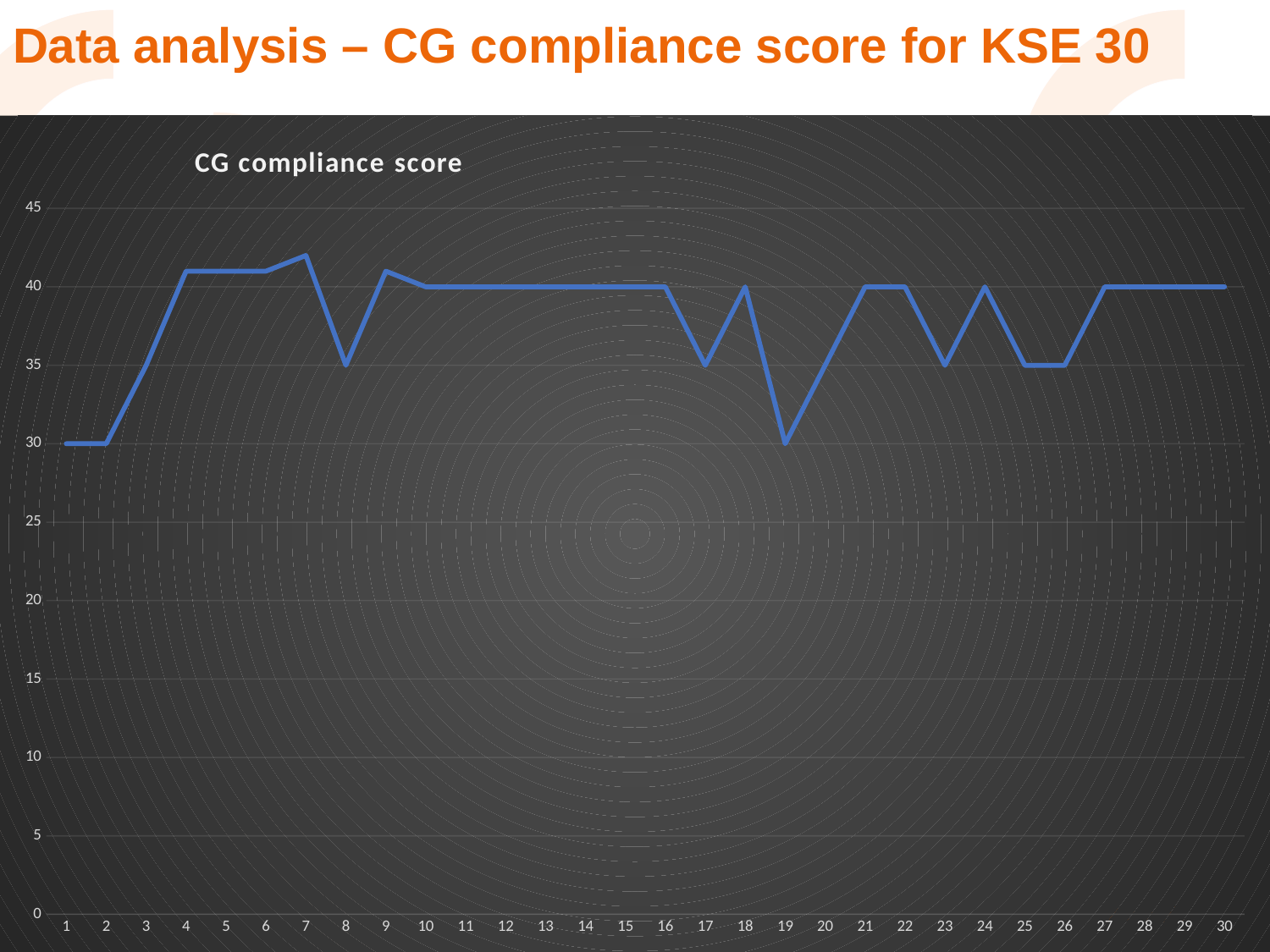
What kind of chart is shown on the slide? line chart Does the CG compliance score rise or fall from point 1 to point 4? rise What is the lowest CG compliance score shown on the chart? 30 How many points are plotted along the x axis? 30 Which has the higher CG compliance score, point 18 or point 19? point 18 What is the CG compliance score at point 19? 30 What is the CG compliance score at point 1? 30 Is the CG compliance score at point 7 greater or less than 40? greater What is the CG compliance score at point 10? 40 What is the difference between the CG compliance score at point 10 and at point 19? 10 What is the CG compliance score at point 8? 35 What is the title of the chart? CG compliance score